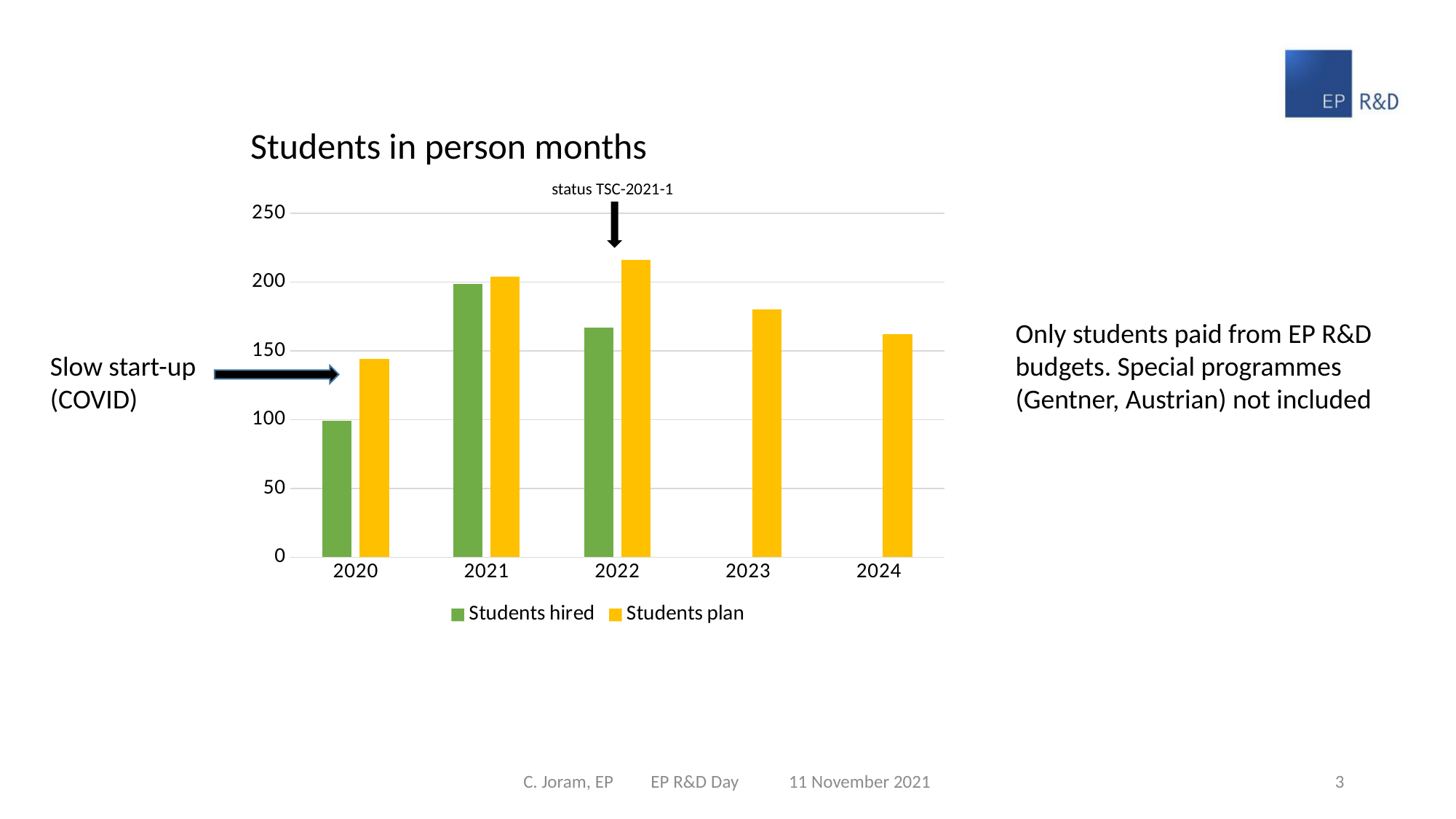
How many series does the legend list? 2 In which year is the Students plan value highest? 2022 Is the Students plan value for 2022 greater or less than 200? greater What colour are the Students hired bars? Green How many years are shown on the x axis? 5 Does the Students plan value rise or fall from 2022 to 2024? Fall In which year is the Students plan value lowest? 2020 In which year is the Students hired value lowest? 2020 In 2020, which is larger: Students hired or Students plan? Students plan In which year is the Students hired value highest? 2021 Is the Students hired value for 2021 greater or less than 150? greater What kind of chart is shown on the slide? Bar chart